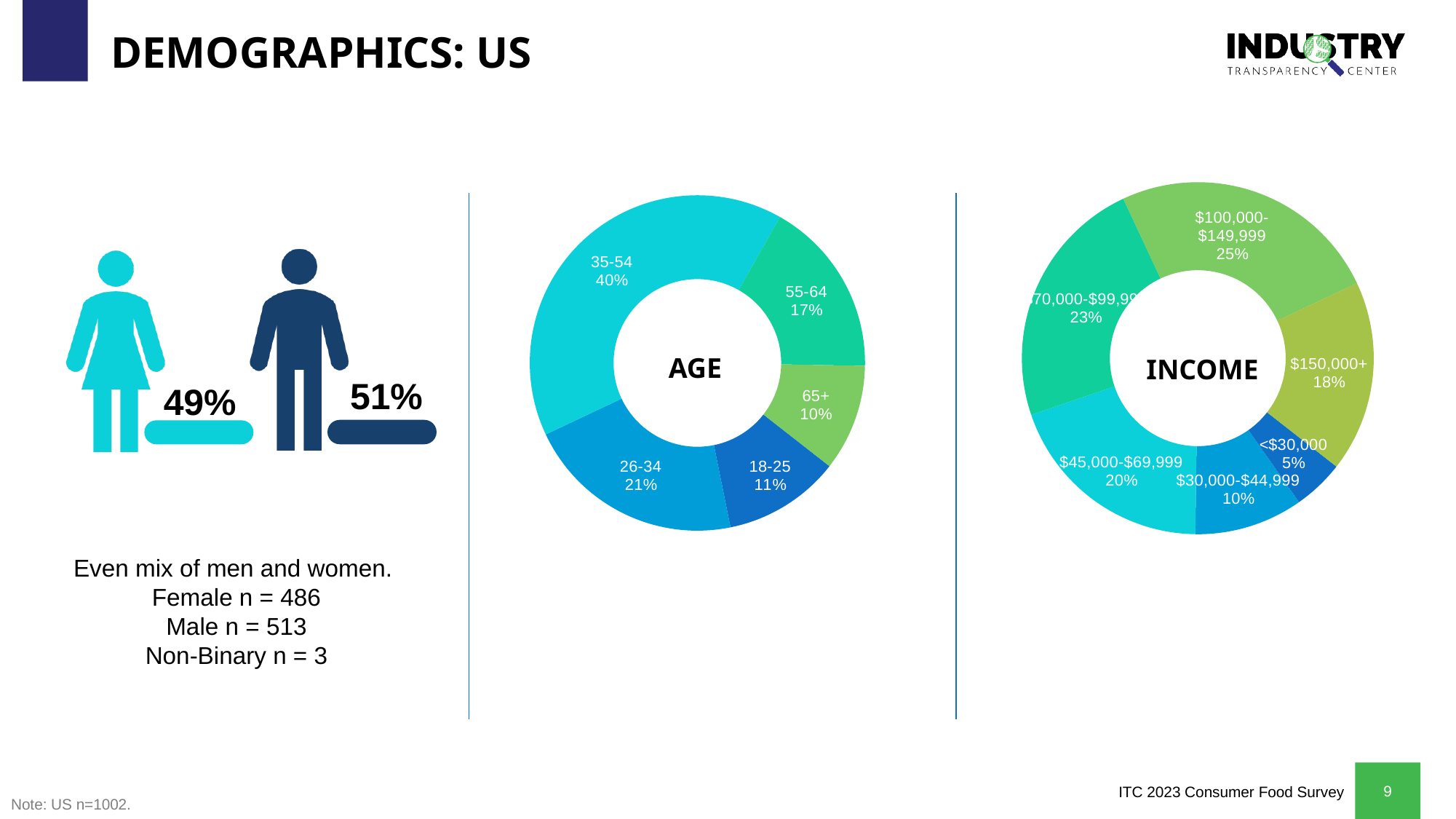
In the AGE chart, which age group has the smallest share? 65+ In the AGE chart, what share of respondents are aged 35-54? 40% In the AGE chart, what is the difference between the 26-34 share and the 18-25 share? 10% In the AGE chart, which age group has the largest share? 35-54 In the AGE chart, how many age groups are shown? 5 In the INCOME chart, which income group has the smallest share? <$30,000 In the INCOME chart, which income group has the largest share? $100,000-$149,999 In the INCOME chart, what is the difference between the $70,000-$99,999 share and the $30,000-$44,999 share? 13% In the INCOME chart, what share of respondents earn $100,000-$149,999? 25% What type of chart is the AGE chart? Doughnut chart In the INCOME chart, how many income groups are shown? 6 In the INCOME chart, which is larger: the share for $150,000+ or the share for $45,000-$69,999? $45,000-$69,999